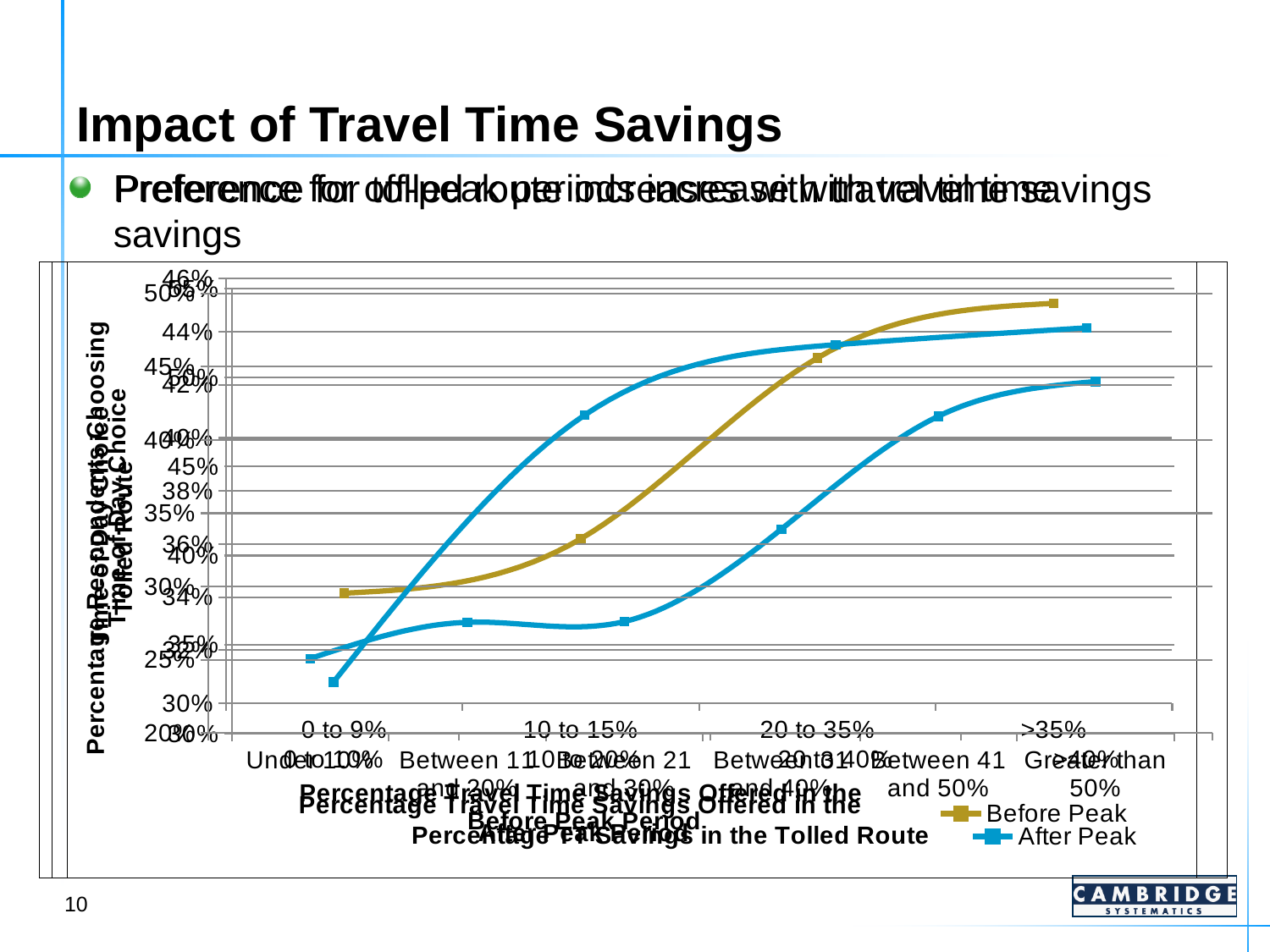
What are the two series named in the chart legend? Before Peak and After Peak What colour is the Before Peak series line in the chart? gold How many series does the chart legend list? 2 What kind of chart is shown on the slide? line chart Do the plotted values generally rise or fall from left to right along the x axis? rise